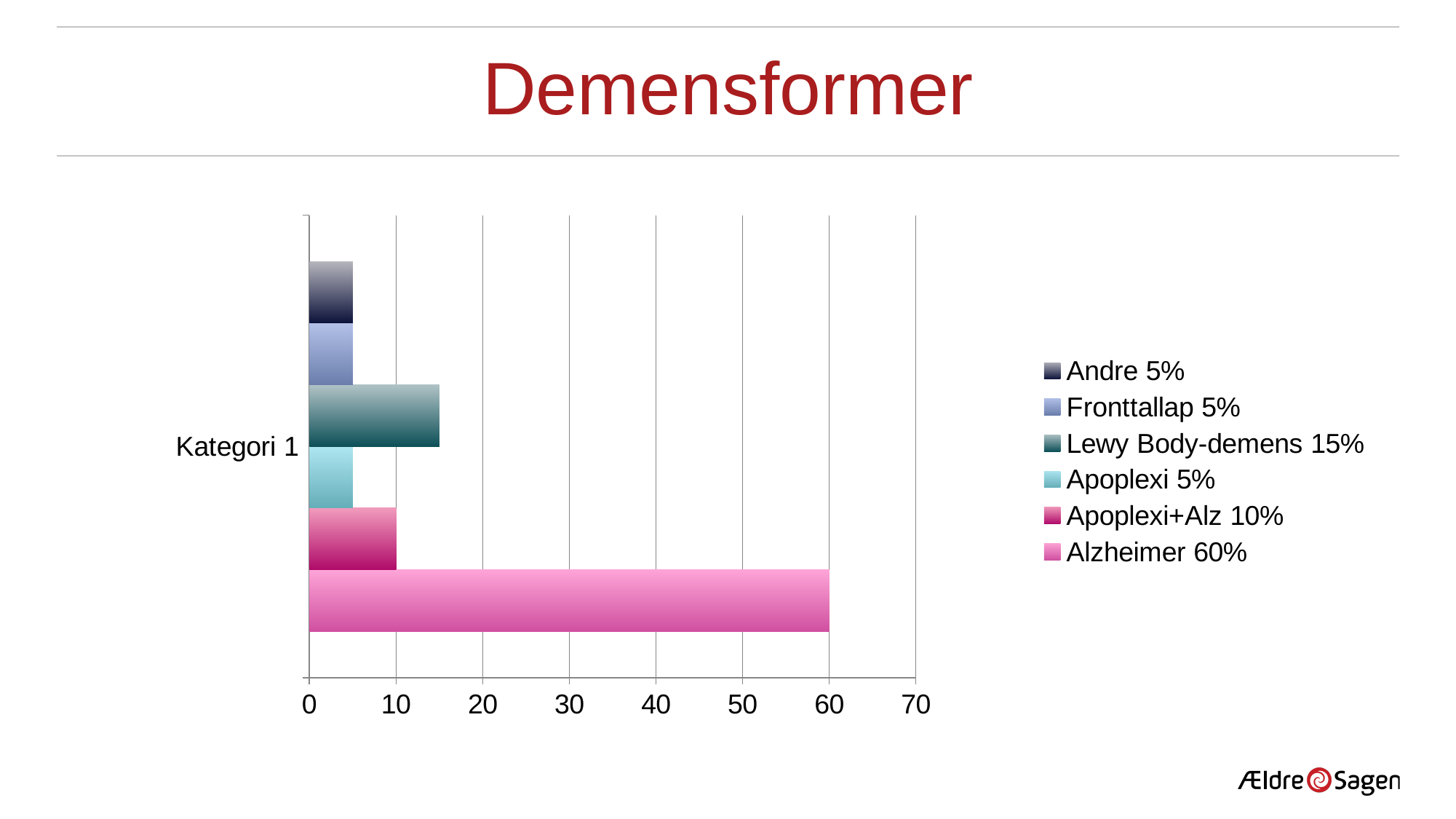
What is the difference between the values for Alzheimer and Lewy Body-demens? 45% What is the value for Alzheimer? 60% Which series has the highest value? Alzheimer How many categories are shown on the vertical axis? 1 What is the value for Apoplexi+Alz? 10% Which is larger, the value for Lewy Body-demens or the value for Apoplexi+Alz? Lewy Body-demens How many series does the legend list? 6 What kind of chart is shown on the slide? bar chart What is the value for Lewy Body-demens? 15% Is the value for Alzheimer greater or less than 50? greater What is the title of the chart on the slide? Demensformer What is the value for Fronttallap? 5%